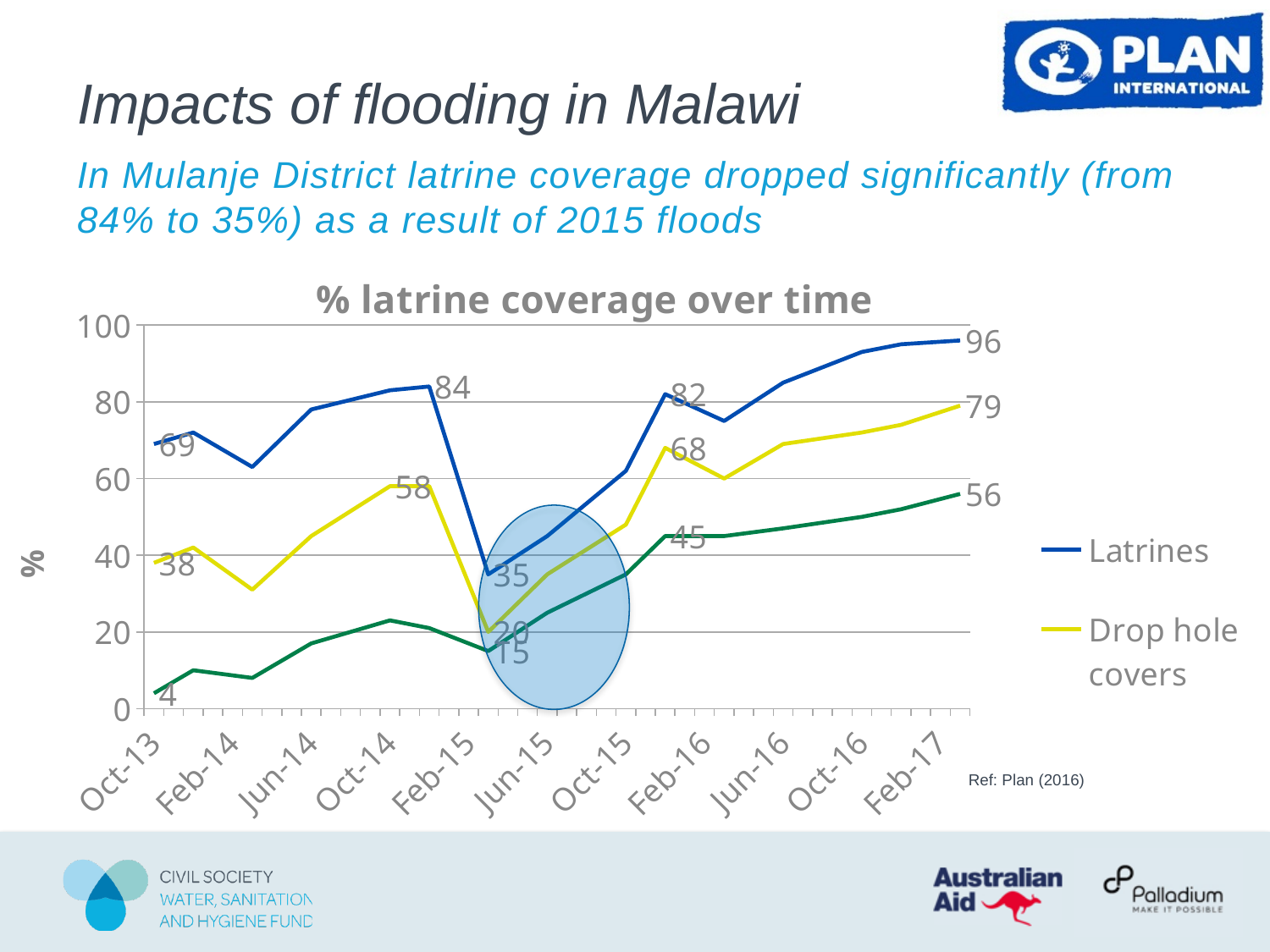
What is the Drop hole covers value at the first point (Oct-13)? 38 Is the Latrines value at Oct-16 greater or less than 80? greater What is the title of the chart? % latrine coverage over time What is the Drop hole covers value at the last point (Feb-17)? 79 At Feb-17, which series has the larger value, Latrines or Drop hole covers? Latrines How many series does the chart legend list? 2 What is the Latrines value at the first point (Oct-13)? 69 What is the difference between the Latrines peak of 84 and the subsequent low of 35? 49 What is the lowest labelled value on the Latrines line? 35 What kind of chart is shown on the slide? line chart At Feb-17, how much higher is the Latrines value than the Drop hole covers value? 17 What is the Latrines value at the last point (Feb-17)? 96